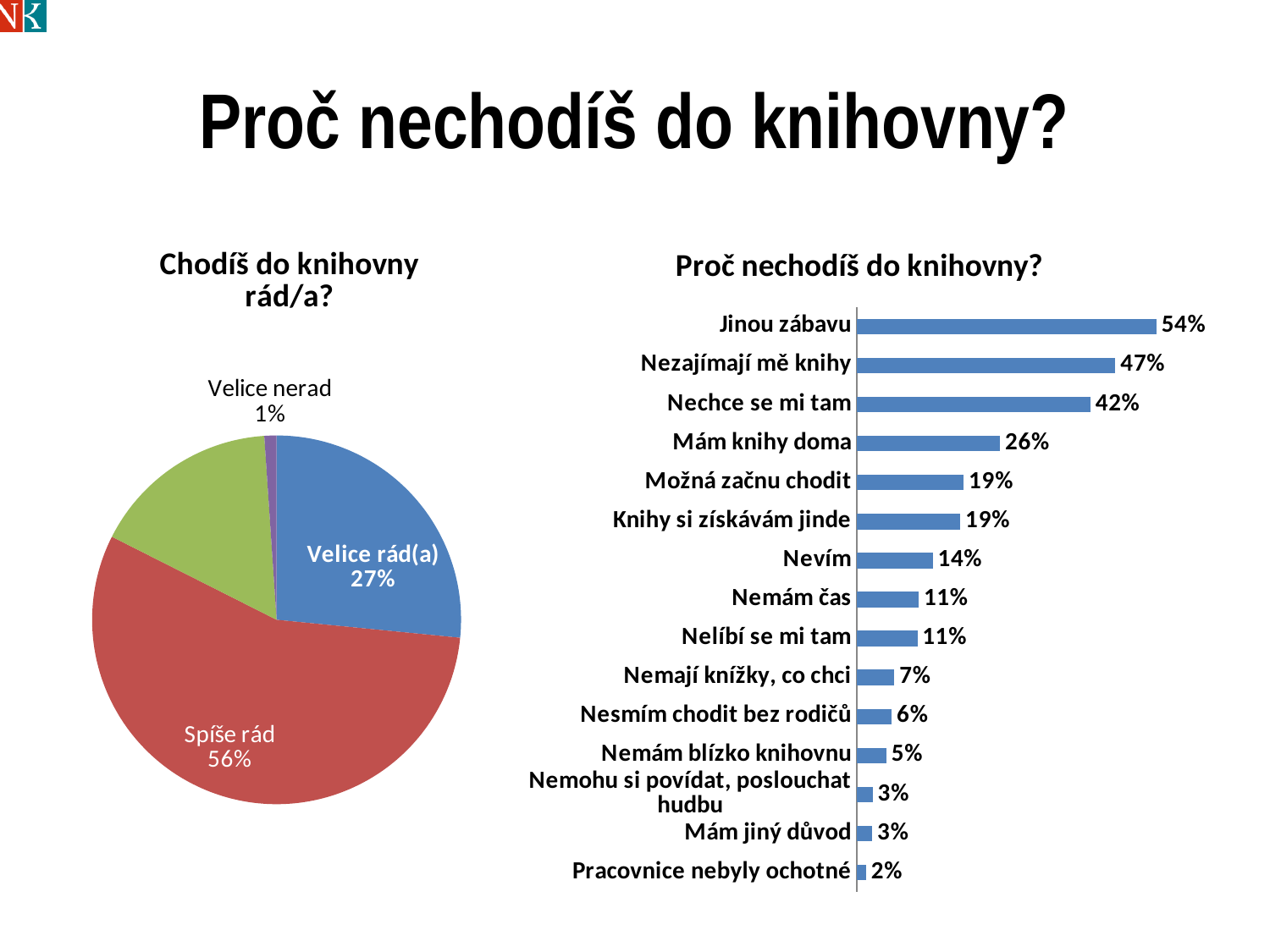
In the bar chart 'Proč nechodíš do knihovny?', what is the value for 'Jinou zábavu'? 54% How many categories does the bar chart 'Proč nechodíš do knihovny?' show? 15 In the bar chart 'Proč nechodíš do knihovny?', which category has the highest value? Jinou zábavu In the bar chart 'Proč nechodíš do knihovny?', which is larger: 'Nevím' or 'Nemám čas'? Nevím What kind of chart is 'Chodíš do knihovny rád/a?'? Pie chart In the pie chart 'Chodíš do knihovny rád/a?', what is the difference between 'Spíše rád' and 'Velice rád(a)'? 29% In the bar chart 'Proč nechodíš do knihovny?', what is the value for 'Mám knihy doma'? 26% In the bar chart 'Proč nechodíš do knihovny?', what is the difference between 'Nezajímají mě knihy' and 'Nechce se mi tam'? 5% In the pie chart 'Chodíš do knihovny rád/a?', what share does 'Spíše rád' have? 56% In the pie chart 'Chodíš do knihovny rád/a?', what is the value for 'Velice nerad'? 1% What kind of chart is 'Proč nechodíš do knihovny?'? Bar chart In the bar chart 'Proč nechodíš do knihovny?', which category has the lowest value? Pracovnice nebyly ochotné